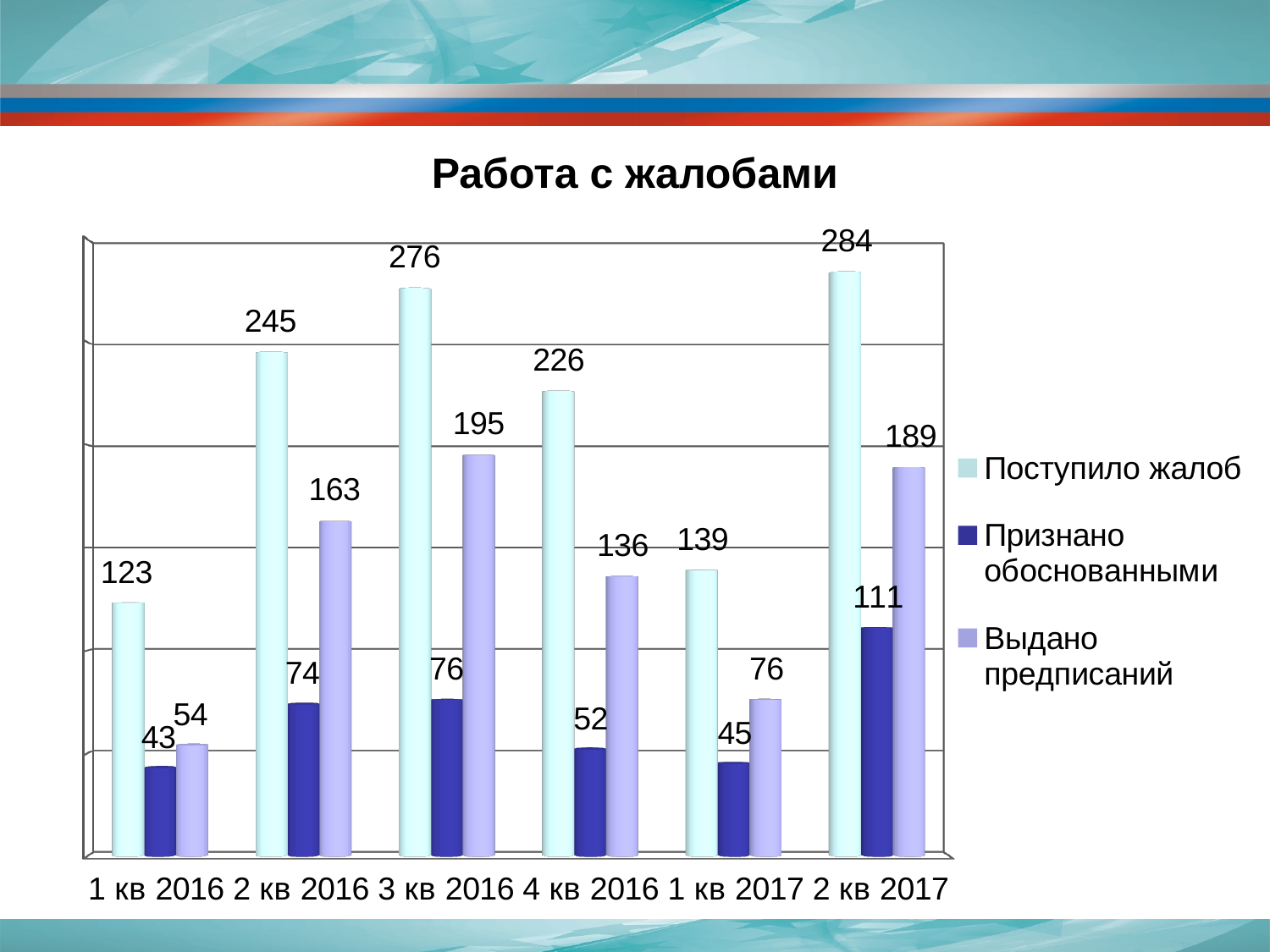
What is the value of "Признано обоснованными" for 2 кв 2017? 111 How many series does the legend list? 3 What is the value of "Выдано предписаний" for 4 кв 2016? 136 Which quarter has the lowest value for "Признано обоснованными"? 1 кв 2016 Which is larger: "Выдано предписаний" for 2 кв 2016 or for 3 кв 2016? 3 кв 2016 Which quarter has the highest value for "Поступило жалоб"? 2 кв 2017 What is the difference between "Поступило жалоб" and "Выдано предписаний" for 2 кв 2017? 95 How many quarters are shown on the x axis? 6 What is the title of the chart? Работа с жалобами What is the value of "Поступило жалоб" for 3 кв 2016? 276 What kind of chart is shown on the slide? Bar chart What is the difference between "Признано обоснованными" for 2 кв 2017 and 1 кв 2017? 66